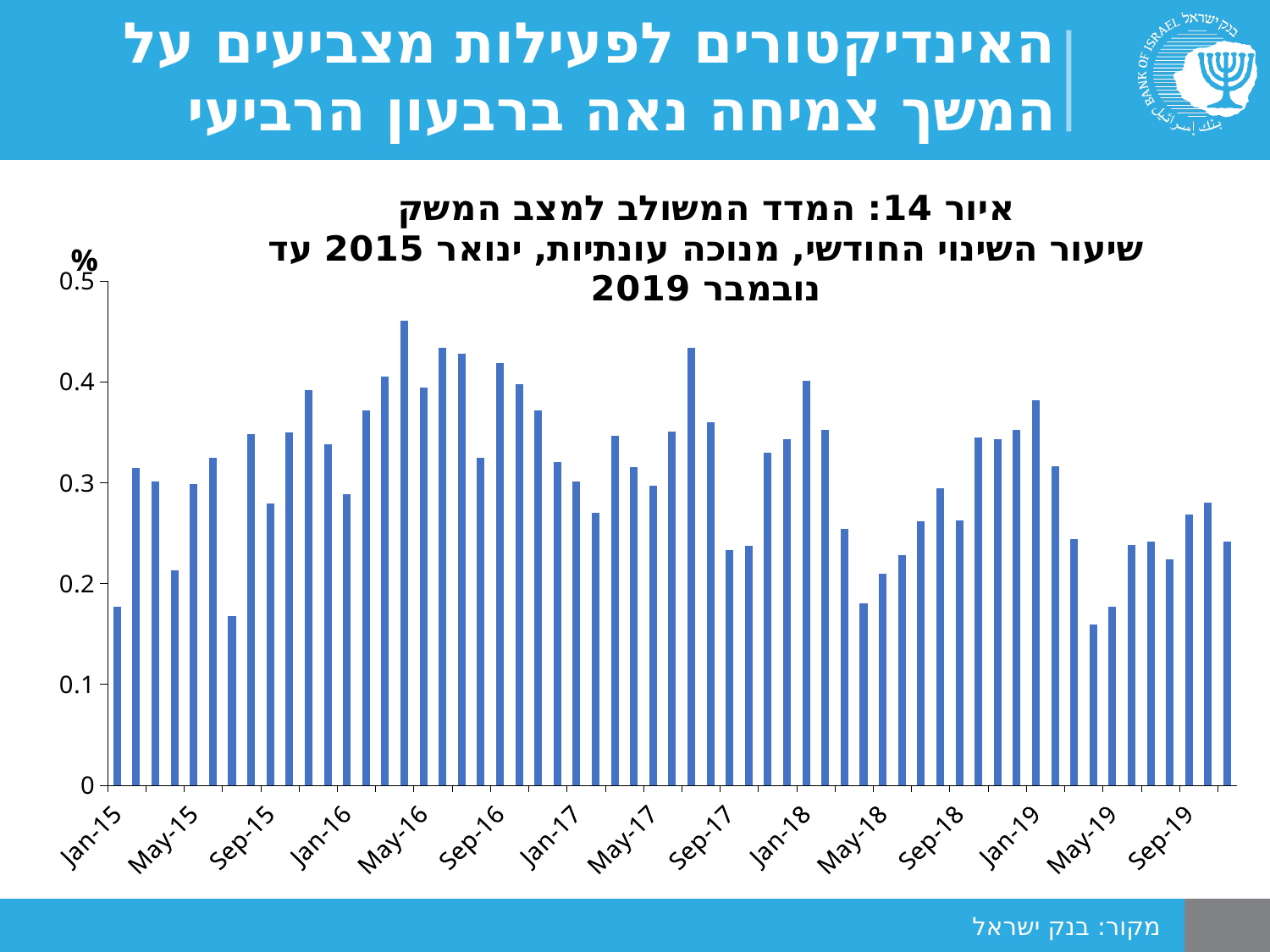
Is the value for Sep-16 greater or less than 0.4? greater Is the value for Sep-17 greater or less than 0.4? less What unit is shown at the top of the vertical axis? % Is the value for Jan-15 greater or less than 0.2? less Which is larger, the value for Jan-15 or the value for Sep-15? Sep-15 Which is larger, the value for Sep-17 or the value for May-18? Sep-17 How many data series are plotted in the chart? 1 What kind of chart is shown on the slide? bar chart